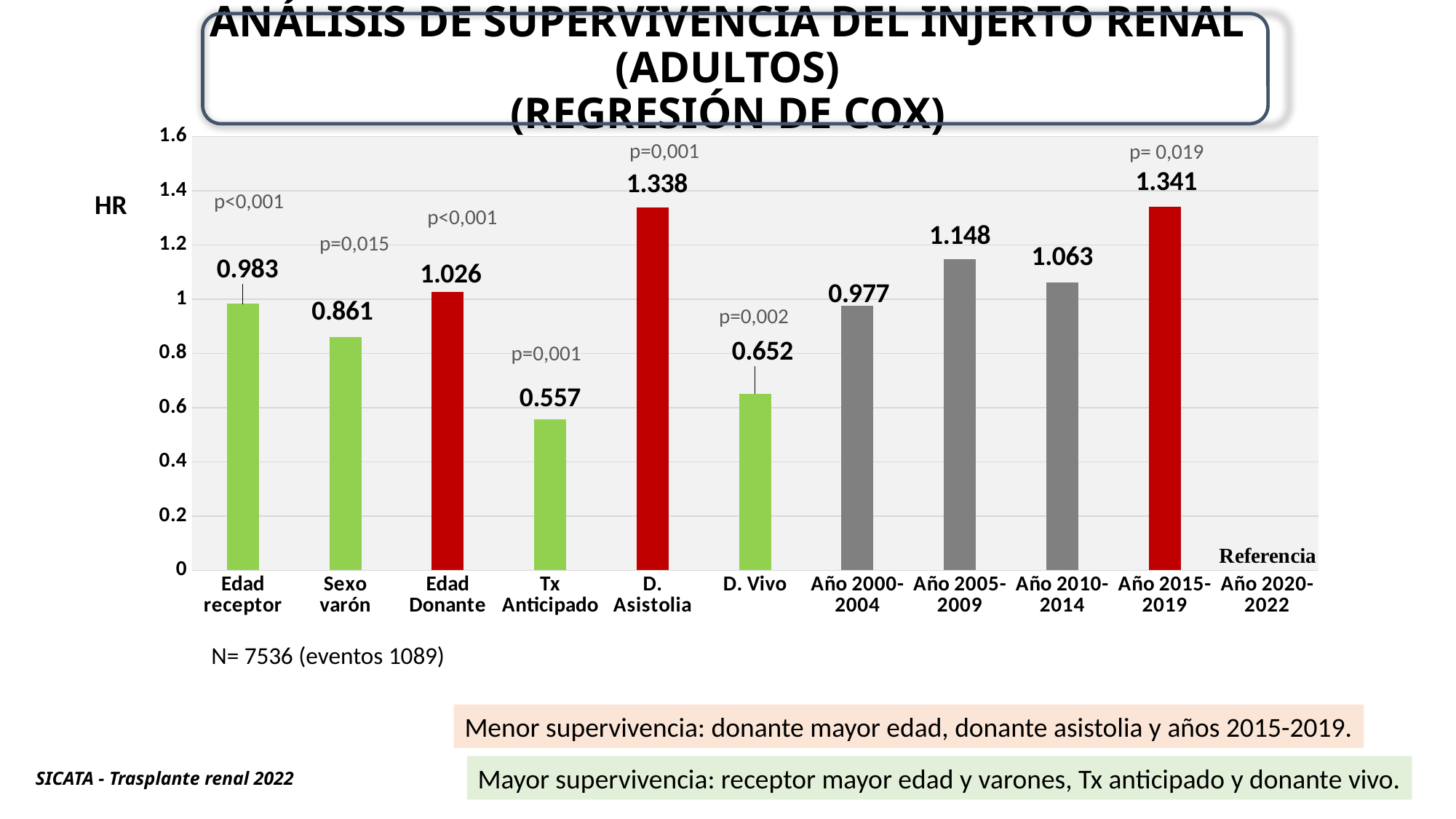
Is the HR value for D. Vivo greater or less than 0.8? less What is the HR value for Tx Anticipado? 0.557 Which has a higher HR value, Edad receptor or Sexo varón? Edad receptor What label is shown on the vertical axis of the chart? HR What is the HR value for D. Asistolia? 1.338 What is the HR value for Año 2005-2009? 1.148 What is the difference between the HR values for D. Asistolia and D. Vivo? 0.686 How many bars are plotted in the chart? 10 What kind of chart is shown on the slide? bar chart What is the HR value for Sexo varón? 0.861 What is the difference between the HR values for Año 2005-2009 and Año 2010-2014? 0.085 Which category has the lowest HR value? Tx Anticipado